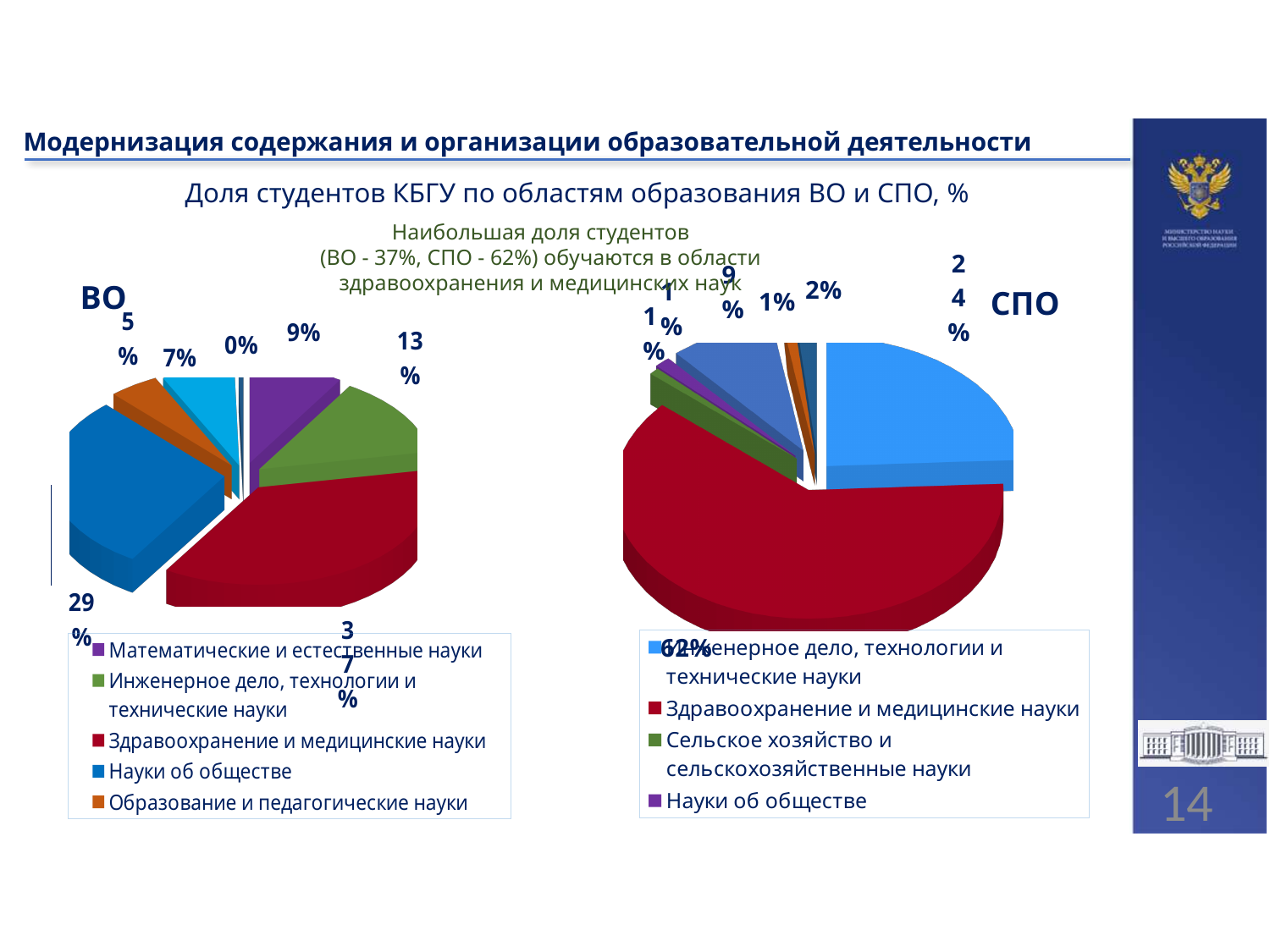
In the ВО chart, by how many percentage points does Здравоохранение и медицинские науки exceed Науки об обществе? 8 In the СПО chart, what share is shown for Инженерное дело, технологии и технические науки? 24% In the СПО chart, which field has the largest share? Здравоохранение и медицинские науки In the СПО chart, what share of students is in Здравоохранение и медицинские науки? 62% In the ВО chart, what share is shown for Науки об обществе? 29% In the ВО chart, what share is shown for Математические и естественные науки? 9% In the ВО chart, what share is shown for Образование и педагогические науки? 5% In the ВО chart, what share is shown for Инженерное дело, технологии и технические науки? 13% In the ВО chart, which is larger: Инженерное дело, технологии и технические науки or Математические и естественные науки? Инженерное дело, технологии и технические науки In the ВО chart, which field has the largest share? Здравоохранение и медицинские науки In the ВО chart, what share of students is in Здравоохранение и медицинские науки? 37% What kind of chart is the ВО chart on the left? pie chart